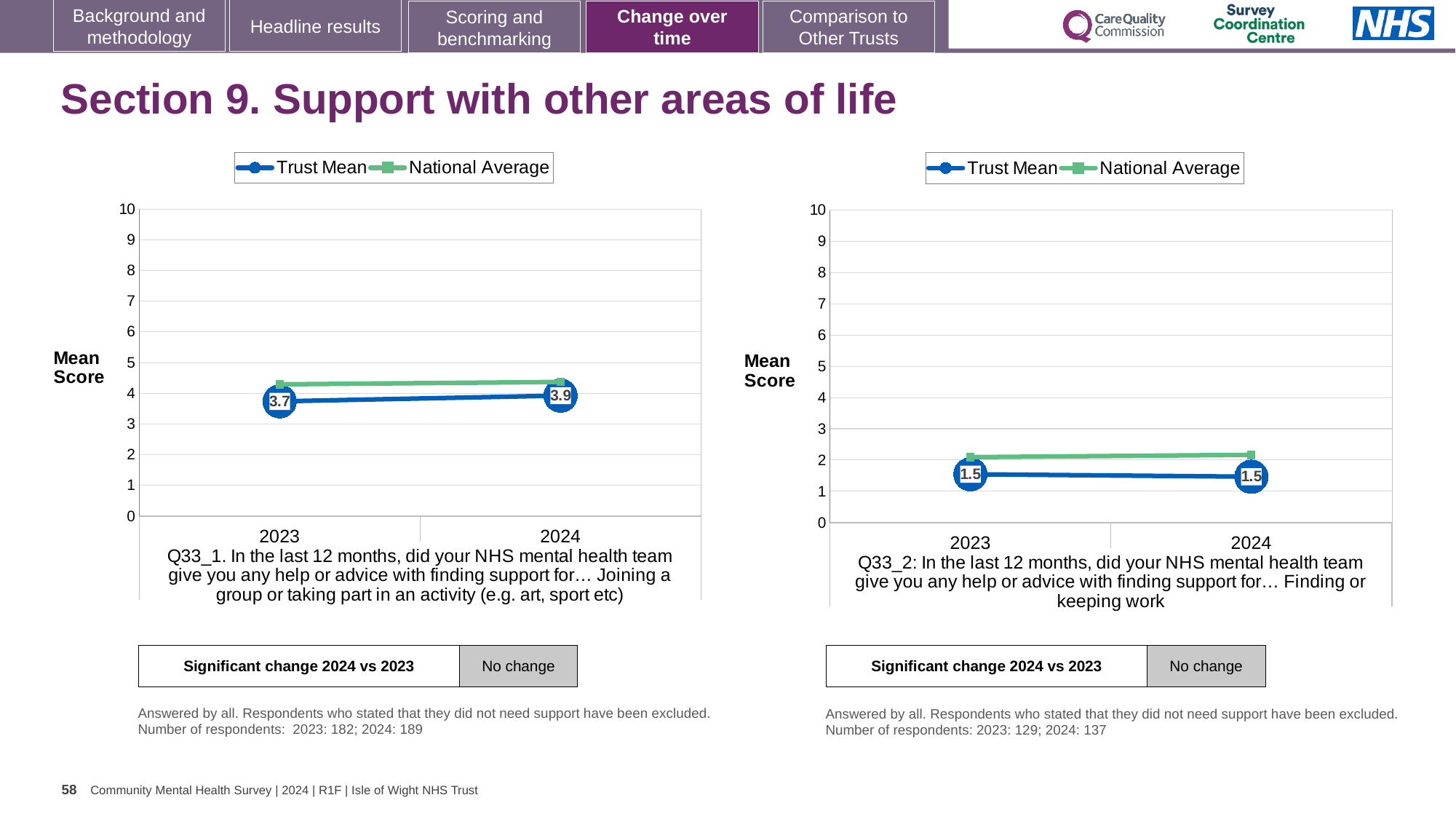
In the left chart (Q33_1), is the Trust Mean higher in 2023 or 2024? 2024 In the right chart (Q33_2), is the National Average for 2024 greater or less than 3? less In the left chart (Q33_1), is the National Average for 2023 greater or less than 4? greater What kind of chart is the left chart (Q33_1)? line chart How many series does the legend of the right chart (Q33_2) list? 2 In the left chart (Q33_1), does the Trust Mean rise or fall from 2023 to 2024? rise In the left chart (Q33_1), what is the Trust Mean for 2024? 3.9 In the right chart (Q33_2), does the Trust Mean rise, fall or stay the same from 2023 to 2024? stays the same In the left chart (Q33_1), by how much did the Trust Mean change from 2023 to 2024? 0.2 In the left chart (Q33_1), what is the Trust Mean for 2023? 3.7 How many years are plotted on the x axis of the left chart (Q33_1)? 2 In the right chart (Q33_2), what is the Trust Mean for 2024? 1.5